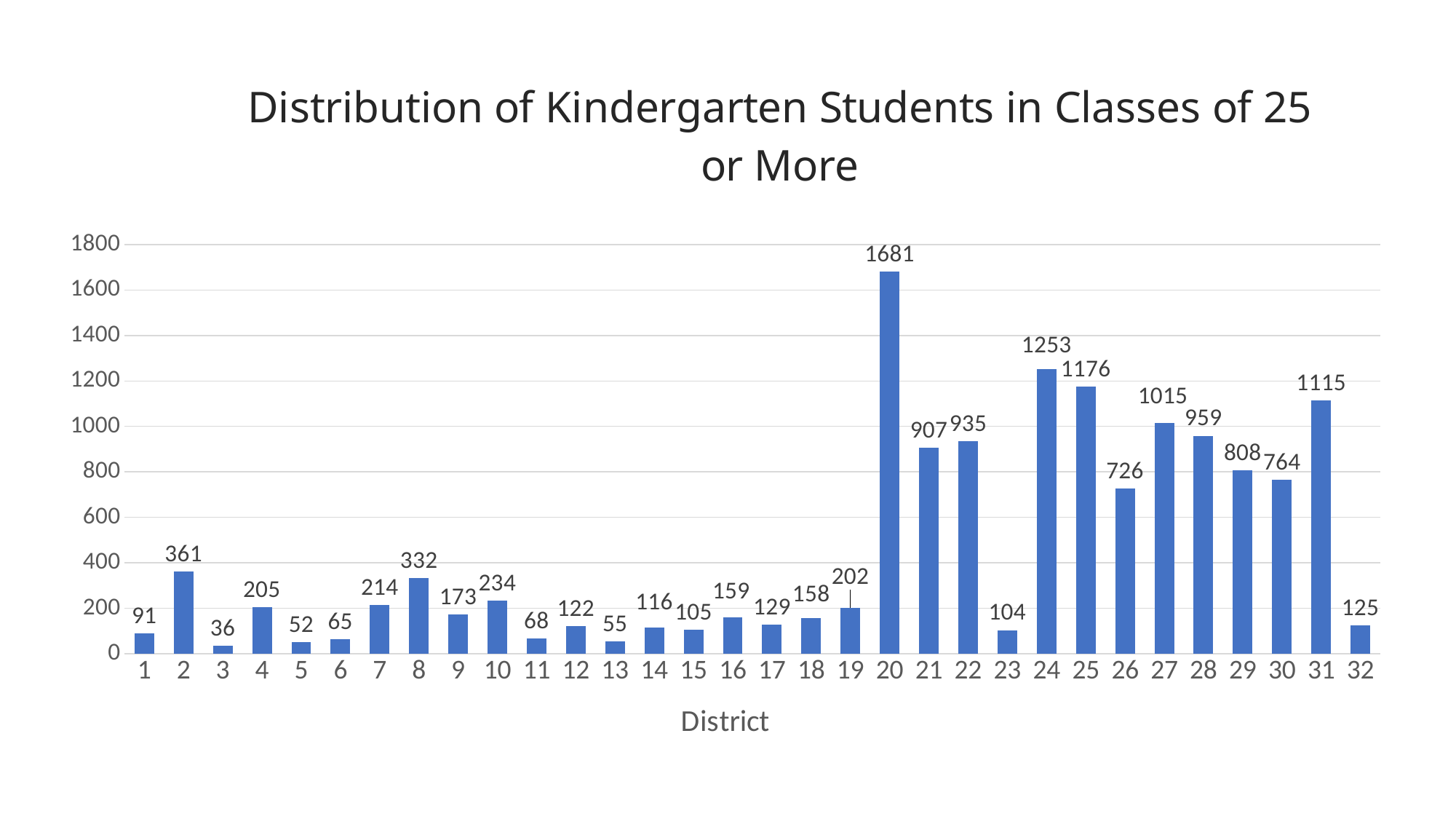
Which district has the lowest value? 3 What kind of chart is this? Bar chart How many districts are shown on the x axis? 32 What is the value for District 20? 1681 Is the value for District 31 greater or less than 1000? greater What is the value for District 26? 726 What is the title of the chart? Distribution of Kindergarten Students in Classes of 25 or More What is the difference between the values for District 24 and District 25? 77 Which district has the highest value? 20 What is the value for District 8? 332 Which is larger, the value for District 2 or the value for District 8? District 2 What is the label of the x axis? District